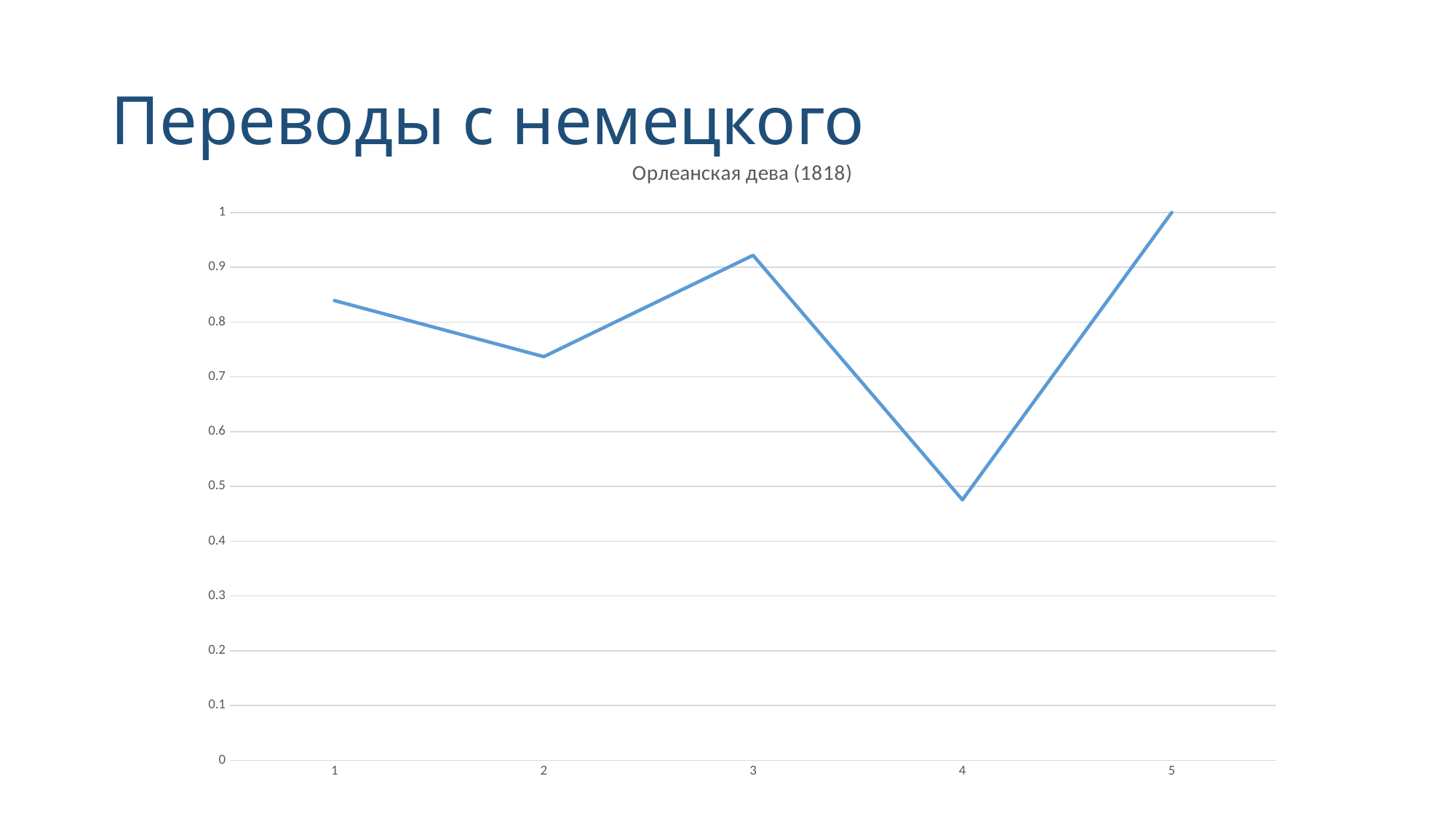
What is the title of the chart? Орлеанская дева (1818) Which x-axis category has the highest value? 5 What is the value at x-axis category 5? 1 Which has the larger value, category 1 or category 2? 1 How many points are plotted on the line? 5 Which x-axis category has the lowest value? 4 Is the value at category 1 greater or less than 0.8? greater Is the value at category 4 greater or less than 0.5? less Is the value at category 2 greater or less than 0.7? greater What kind of chart is shown on the slide? line chart Does the line rise or fall from category 4 to category 5? rise